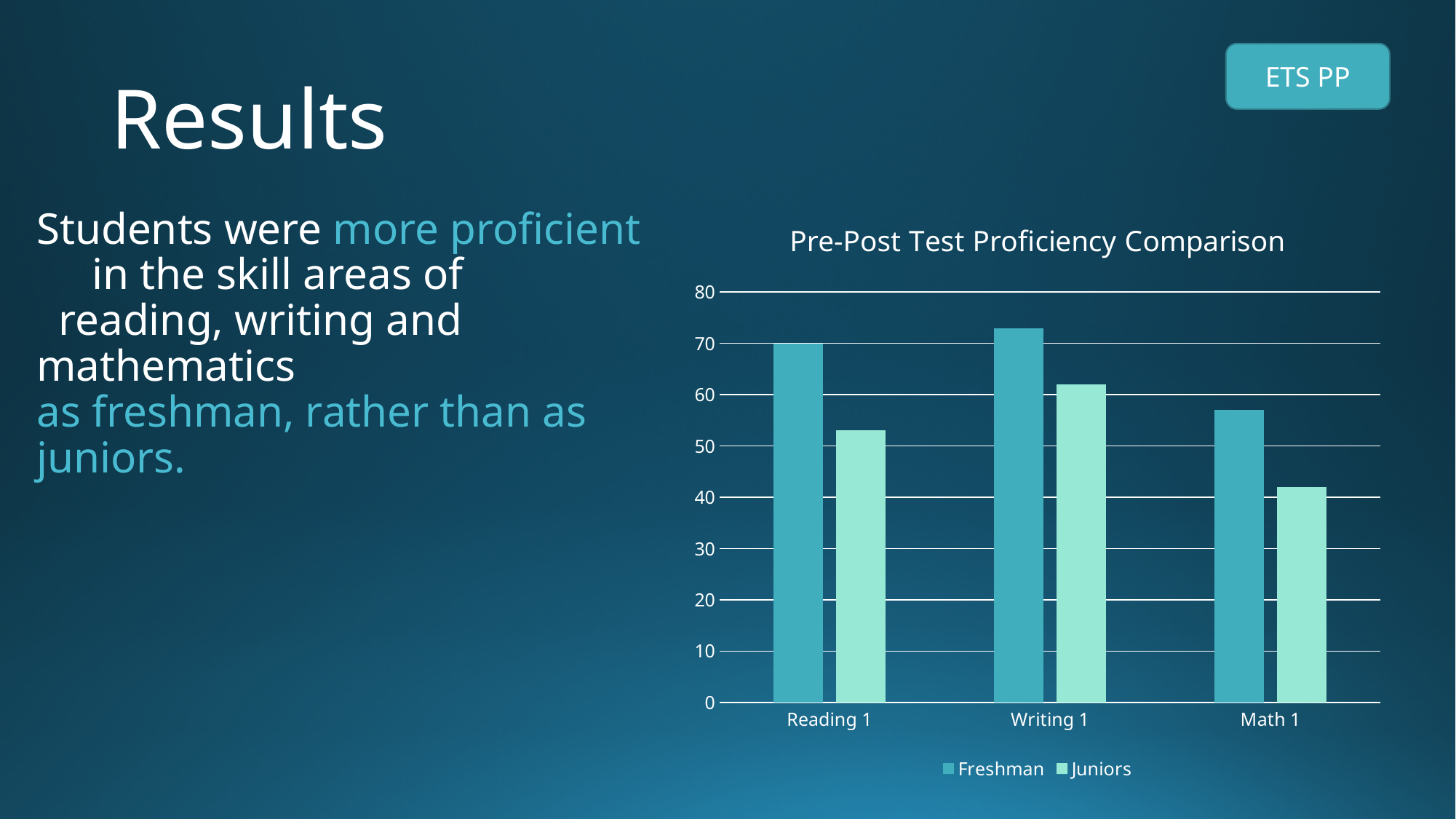
For Reading 1, which is larger: the Freshman value or the Juniors value? Freshman What is the title of the chart? Pre-Post Test Proficiency Comparison What kind of chart is shown on the slide? Bar chart How many categories are shown on the x axis? 3 Is the Freshman value for Writing 1 greater or less than 70? greater Which category has the lowest Juniors value? Math 1 Which category has the highest Freshman value? Writing 1 Which category has the lowest Freshman value? Math 1 How many series does the legend list? 2 Is the Juniors value for Reading 1 greater or less than 50? greater Is the Freshman value for Math 1 greater or less than 60? less